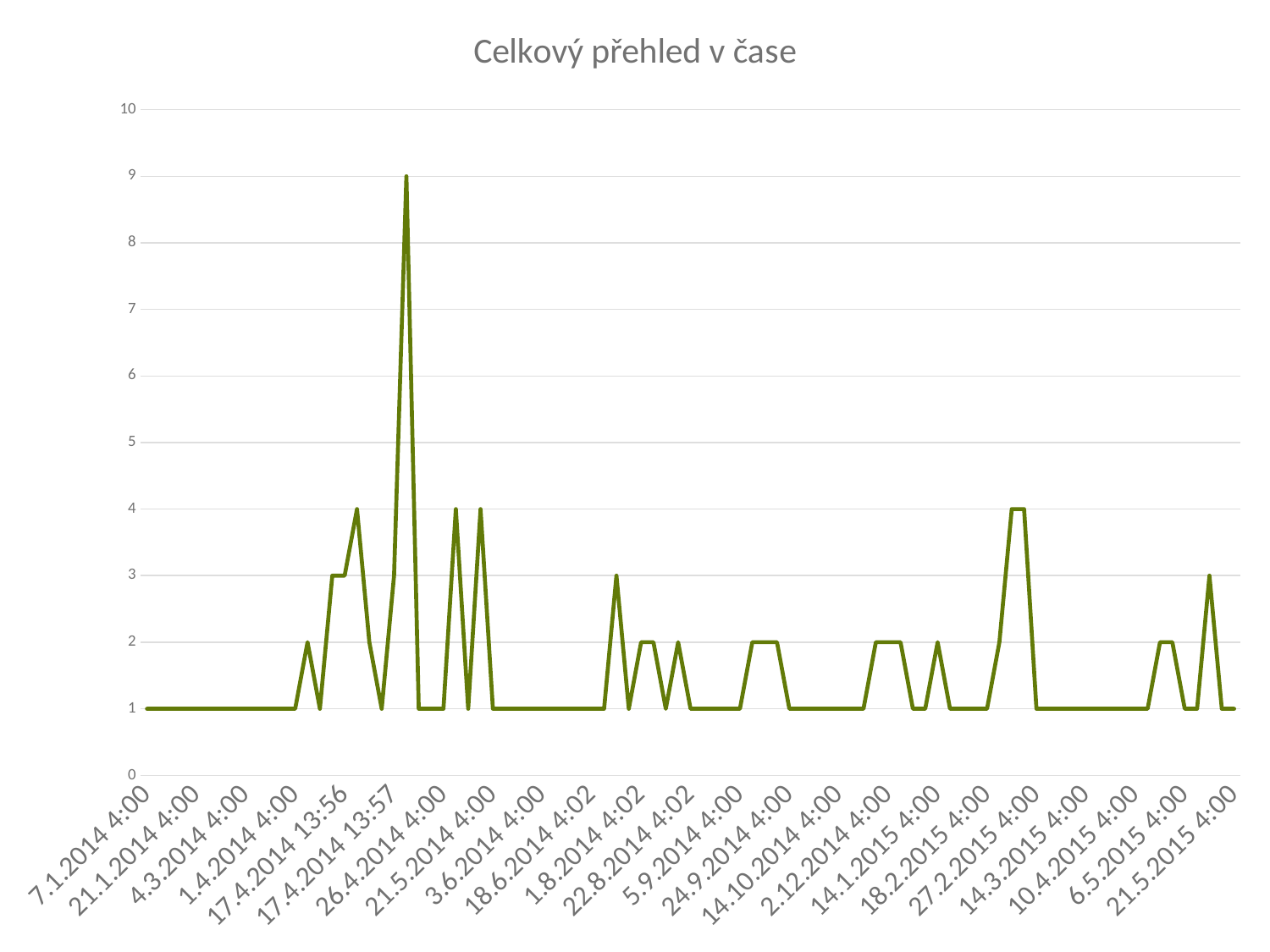
What is the difference between the highest value (9) and the lowest value (1) of the line? 8 What kind of chart is shown on the slide? line chart Does the line ever reach the value 10? No What is the lowest value the line reaches in the chart? 1 What is the value of the line at the last point on the x axis (21.5.2015 4:00)? 1 Is the highest peak of the line greater or less than 8? greater What is the value of the line at the first point on the x axis (7.1.2014 4:00)? 1 Is the lowest value of the line greater or less than 2? less What is the highest tick value shown on the vertical axis? 10 How many lines (series) are plotted in the chart? 1 What is the title of the chart? Celkový přehled v čase What is the highest value reached by the line in the chart? 9